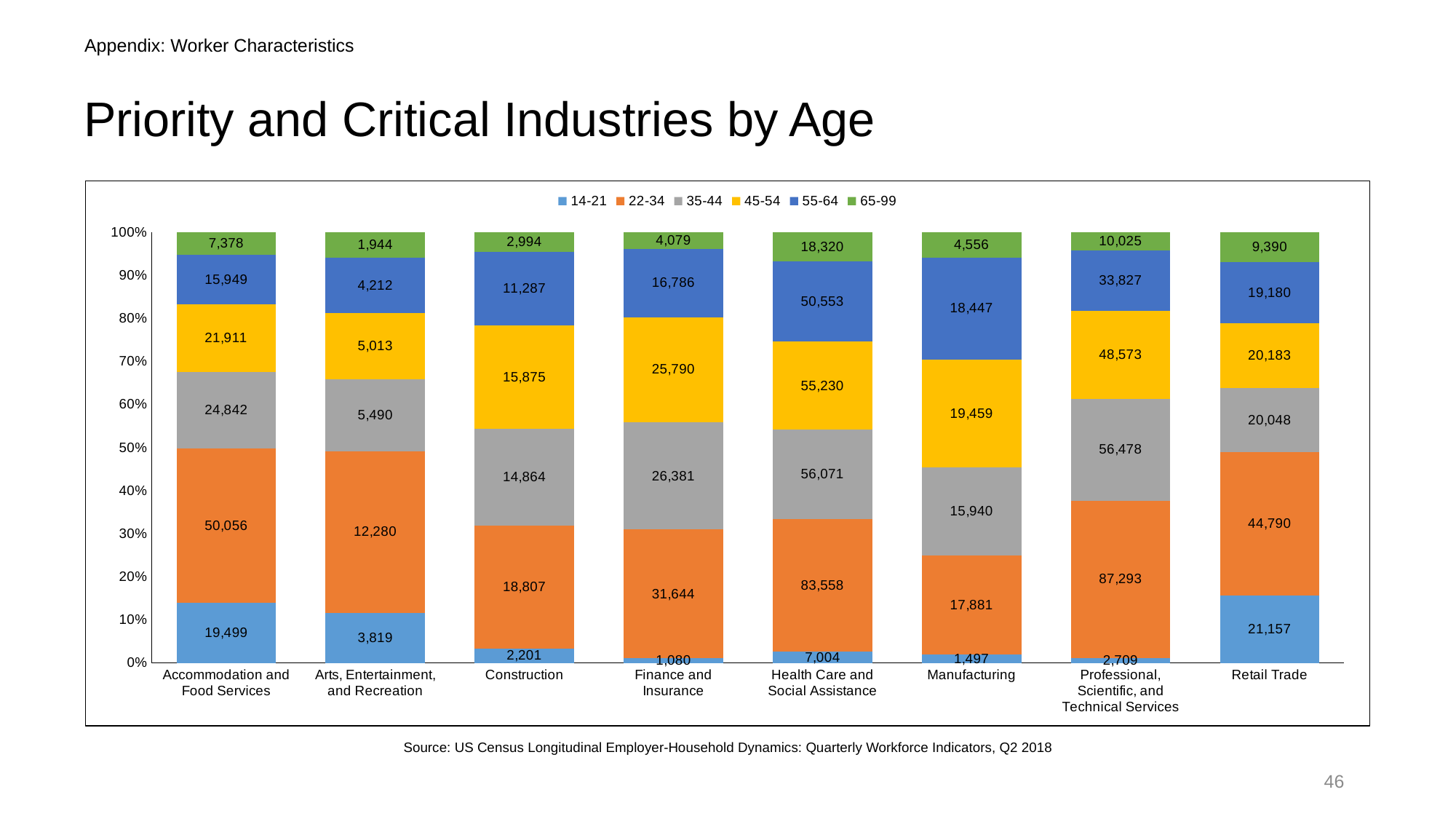
Which industry has the highest value for the 22-34 age group? Professional, Scientific, and Technical Services What is the value for the 35-44 age group in Professional, Scientific, and Technical Services? 56,478 What type of chart is shown on the slide? Stacked bar chart Which industry has the lowest value for the 14-21 age group? Finance and Insurance What is the difference between the 22-34 values for Health Care and Social Assistance and Finance and Insurance? 51,914 What is the total of all age groups for Arts, Entertainment, and Recreation? 32,758 In Construction, which is larger: the 45-54 value or the 35-44 value? 45-54 What is the value for the 65-99 age group in Manufacturing? 4,556 How many age groups does the legend list? 6 How many industries are shown on the x axis of the chart? 8 What is the value for the 14-21 age group in Retail Trade? 21,157 What is the value for the 22-34 age group in Accommodation and Food Services? 50,056